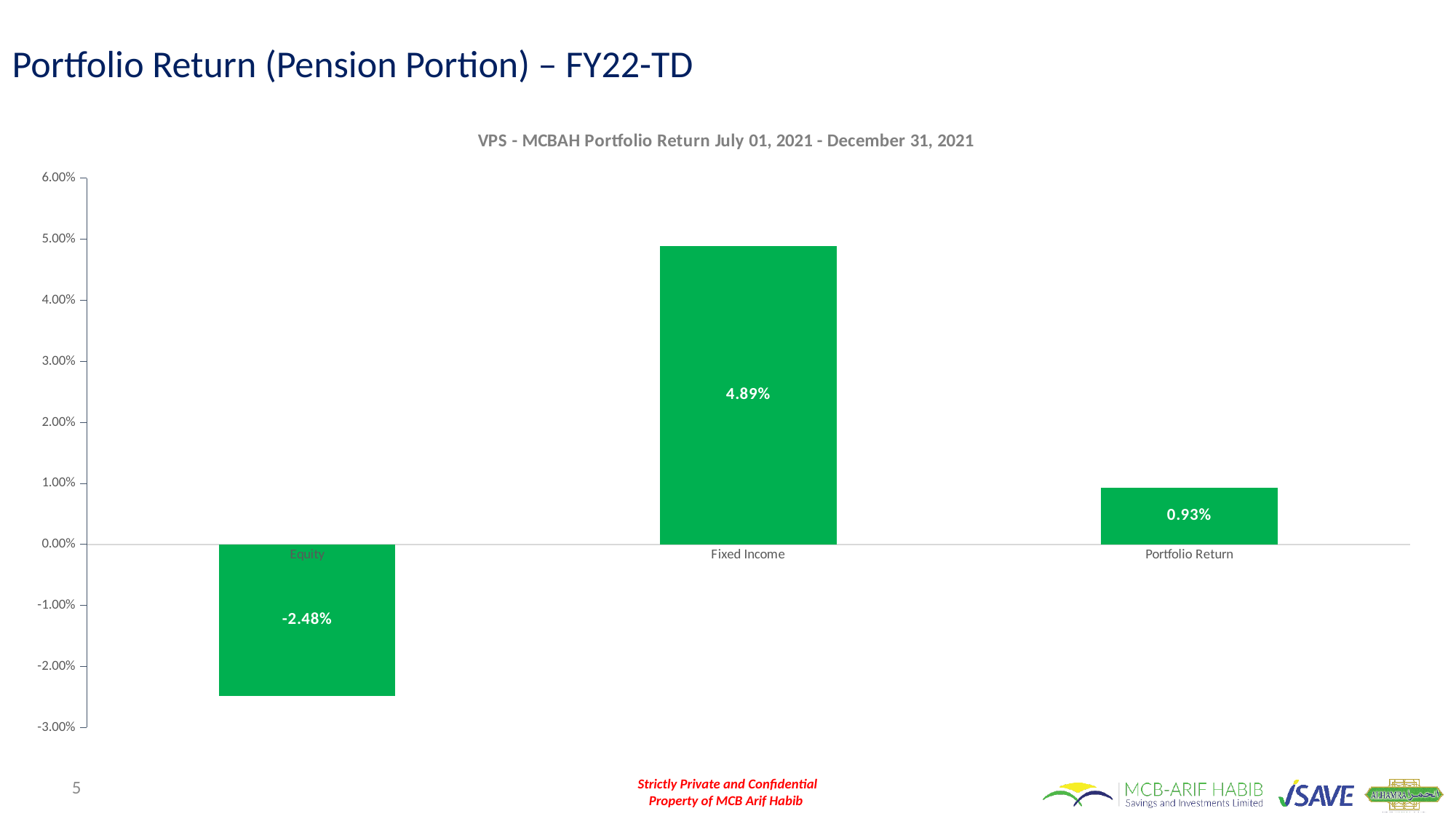
What is the value for Portfolio Return? 0.93% Which category has the lowest value? Equity What is the value for Equity? -2.48% Is the value for Fixed Income greater or less than 4.00%? greater Which is larger, the value for Portfolio Return or the value for Equity? Portfolio Return Which category has the highest value? Fixed Income How many categories are shown on the chart? 3 What is the value for Fixed Income? 4.89% What is the difference between the Fixed Income value and the Equity value? 7.37% What kind of chart is shown on the slide? Bar chart What is the difference between the Fixed Income value and the Portfolio Return value? 3.96% What is the title of the chart? VPS - MCBAH Portfolio Return July 01, 2021 - December 31, 2021